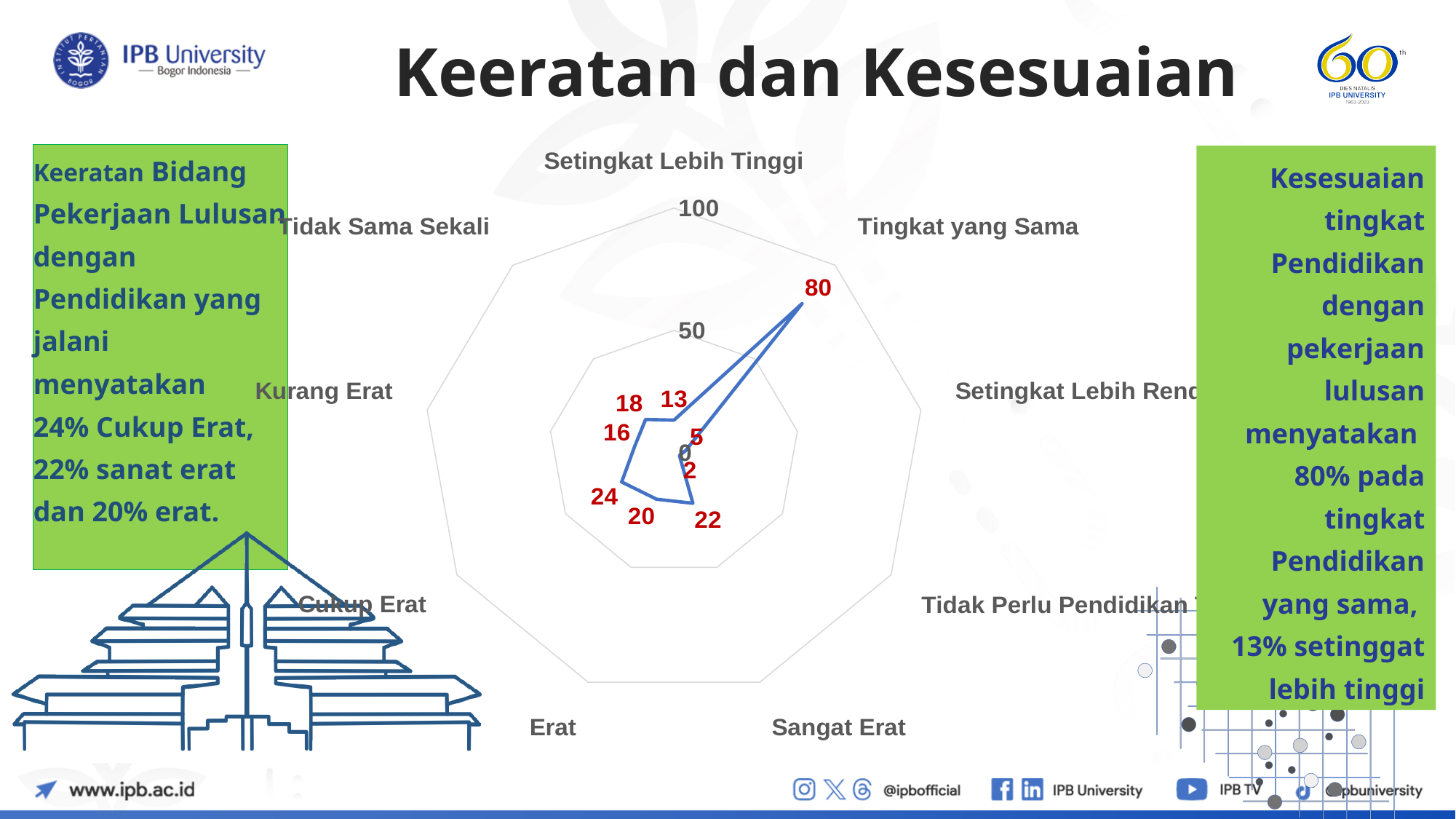
Which is larger, the value for Cukup Erat or the value for Erat? Cukup Erat What is the value for Tidak Sama Sekali? 18 What is the value for Cukup Erat? 24 What is the value for Erat? 20 What is the value for Sangat Erat? 22 What is the value for Setingkat Lebih Tinggi? 13 What is the value for Kurang Erat? 16 Which category has the highest value? Tingkat yang Sama What is the value for Tingkat yang Sama? 80 Is the value for Tingkat yang Sama greater or less than 50? greater What type of chart is shown on the slide? Radar chart What is the difference between the values for Tingkat yang Sama and Setingkat Lebih Tinggi? 67